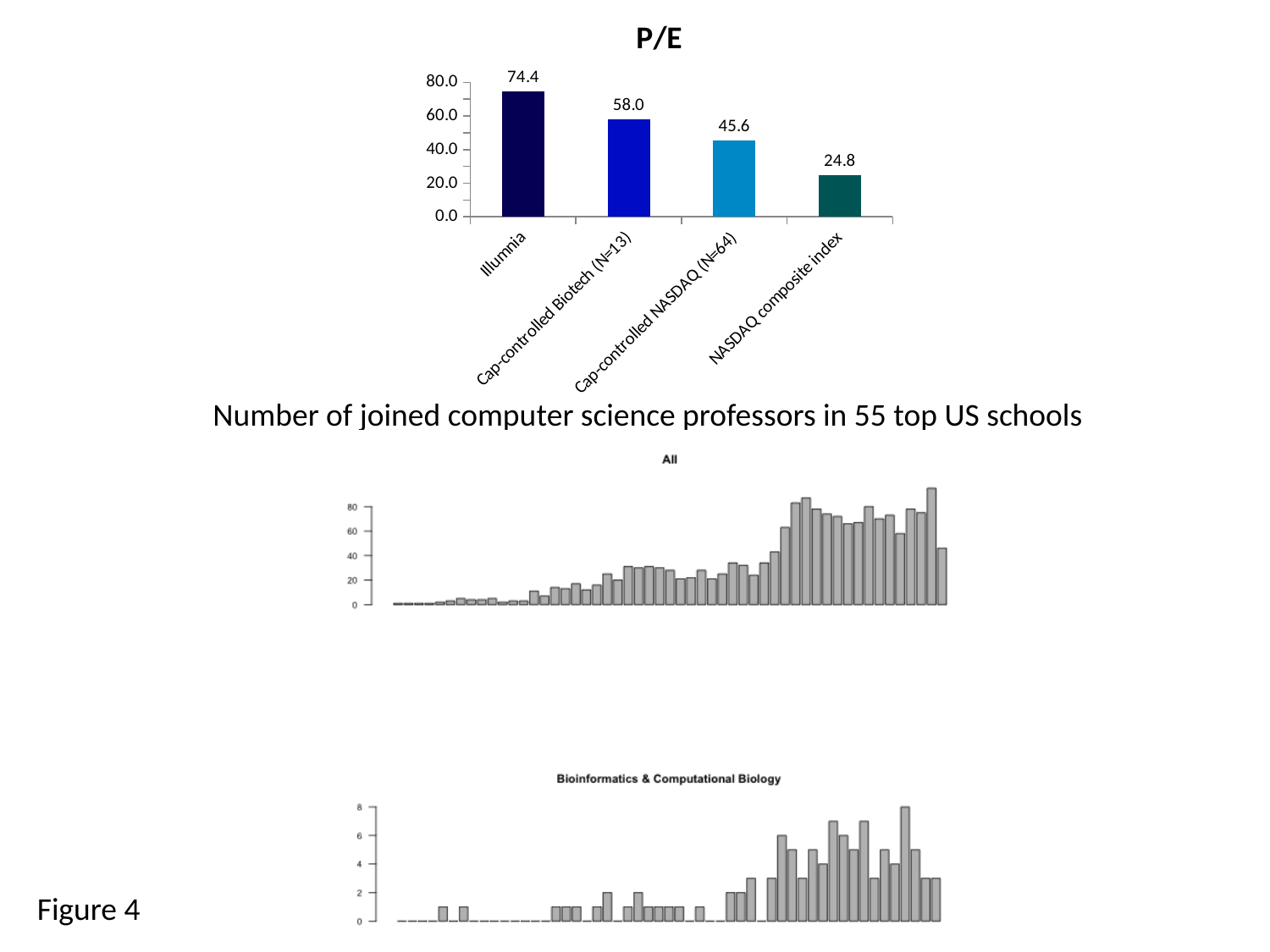
In the P/E chart, which is larger: Cap-controlled Biotech (N=13) or Cap-controlled NASDAQ (N=64)? Cap-controlled Biotech (N=13) In the chart titled 'All', do the values generally rise or fall from left to right? rise In the P/E chart, what is the value for Illumnia? 74.4 What is the title of the top chart on the slide? P/E In the P/E chart, what is the value for NASDAQ composite index? 24.8 In the P/E chart, which category has the highest value? Illumnia In the P/E chart, which category has the lowest value? NASDAQ composite index In the P/E chart, do the values rise or fall from left to right? fall What kind of chart is the P/E chart? bar chart How many categories are shown in the P/E chart? 4 In the P/E chart, what is the difference between the values for Illumnia and NASDAQ composite index? 49.6 In the P/E chart, what is the value for Cap-controlled NASDAQ (N=64)? 45.6